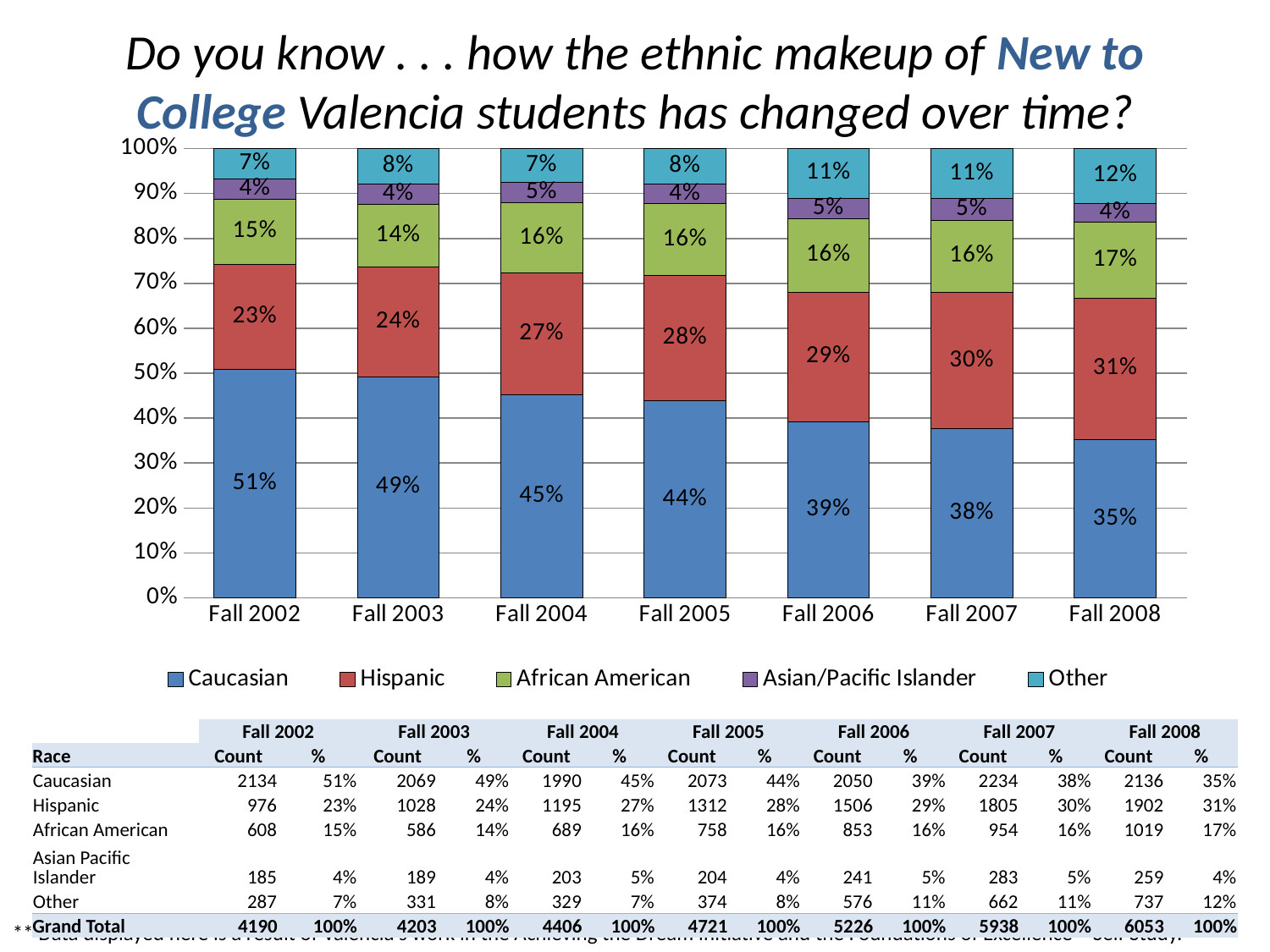
What is the African American share shown for Fall 2007? 16% What percentage is labelled for the Other group in Fall 2006? 11% In which term is the Caucasian share the lowest? Fall 2008 Does the Hispanic share rise or fall from Fall 2002 to Fall 2008? Rise What percentage of New to College students were Caucasian in Fall 2002? 51% Does the Caucasian share rise or fall from Fall 2002 to Fall 2008? Fall By how many percentage points did the Caucasian share fall from Fall 2002 to Fall 2008? 16 percentage points How many ethnic groups does the chart legend list? 5 In which term is the Caucasian share the highest? Fall 2002 What is the Hispanic share shown for Fall 2008? 31% In Fall 2004, which is larger: the Hispanic share or the African American share? Hispanic How many terms are shown on the x axis of the chart? 7